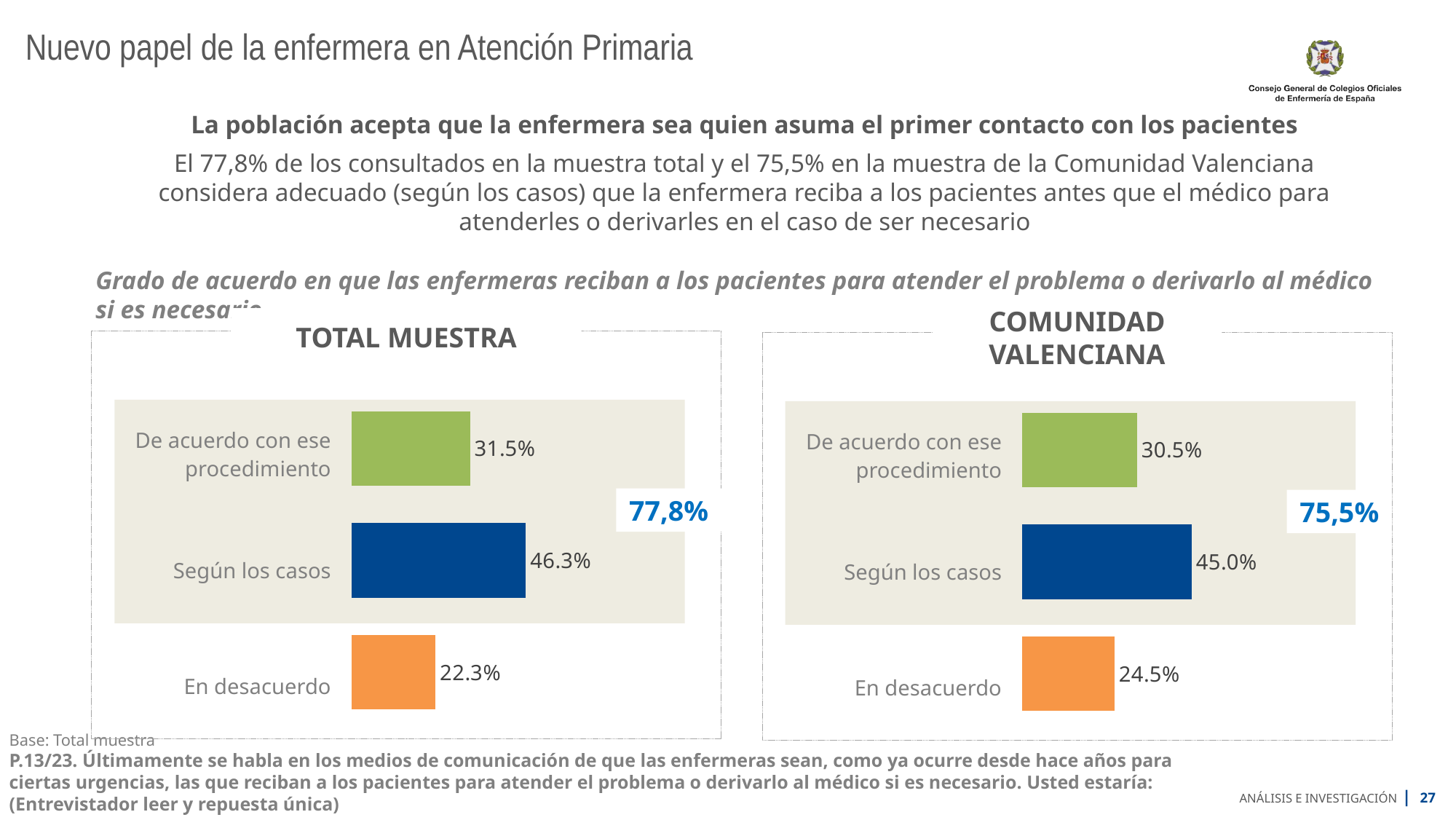
In the TOTAL MUESTRA chart, what is the difference between 'Según los casos' and 'De acuerdo con ese procedimiento'? 14.8% In the TOTAL MUESTRA chart, what is the value for 'Según los casos'? 46.3% In the TOTAL MUESTRA chart, which category has the highest value? Según los casos In the TOTAL MUESTRA chart, what is the value for 'En desacuerdo'? 22.3% What kind of chart is the COMUNIDAD VALENCIANA chart? Bar chart In the COMUNIDAD VALENCIANA chart, which category has the lowest value? En desacuerdo In the COMUNIDAD VALENCIANA chart, what is the value for 'En desacuerdo'? 24.5% In the COMUNIDAD VALENCIANA chart, what is the value for 'De acuerdo con ese procedimiento'? 30.5% Which is larger: 'En desacuerdo' in the TOTAL MUESTRA chart or 'En desacuerdo' in the COMUNIDAD VALENCIANA chart? COMUNIDAD VALENCIANA In the COMUNIDAD VALENCIANA chart, what is the difference between 'Según los casos' and 'En desacuerdo'? 20.5% How many categories does the TOTAL MUESTRA chart show? 3 What combined percentage is highlighted in blue on the COMUNIDAD VALENCIANA chart? 75,5%